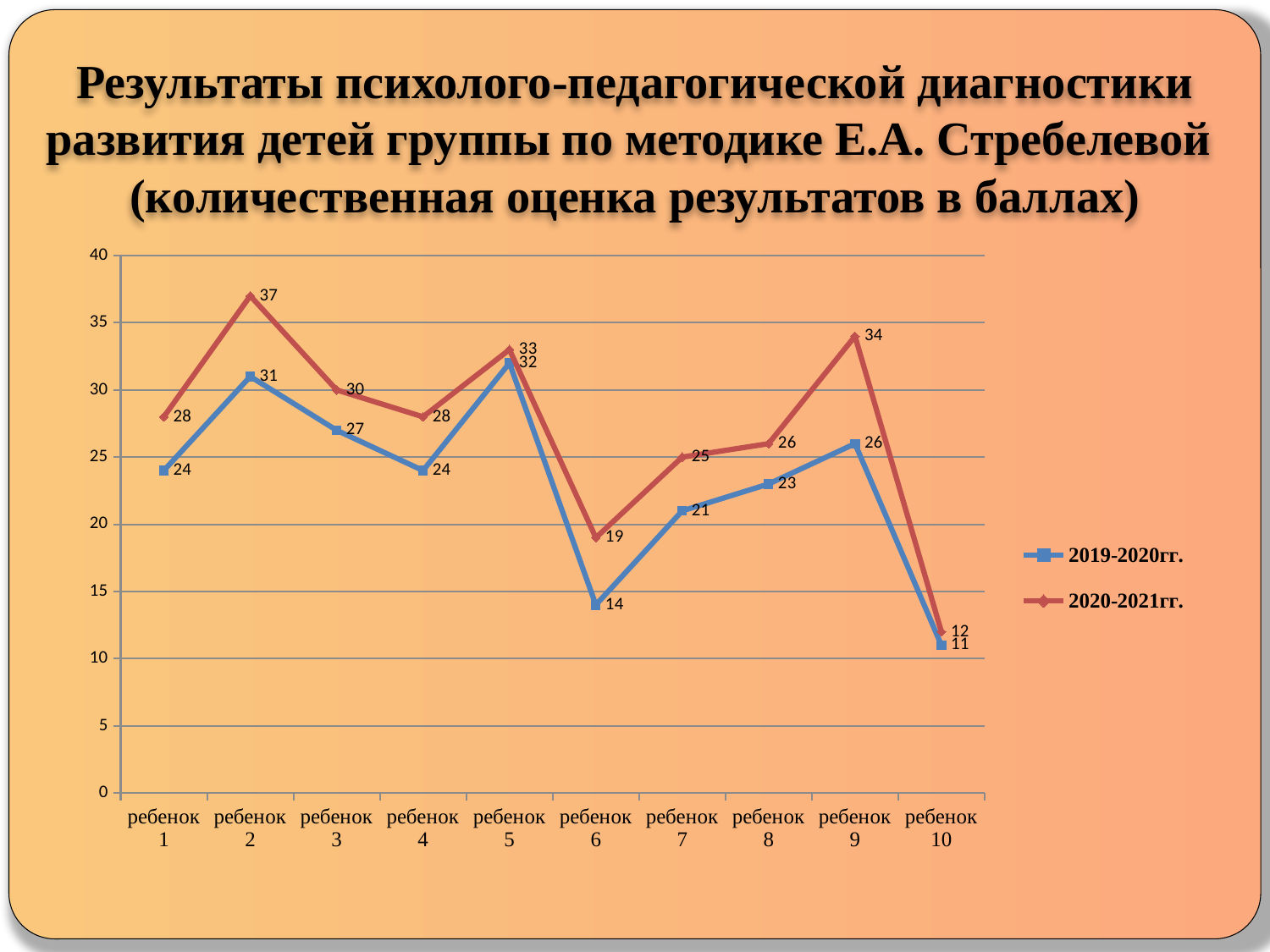
Which child has the lowest value in the 2019-2020гг. series? ребенок 10 How many series does the legend list? 2 Which is larger for ребенок 6: the 2019-2020гг. value or the 2020-2021гг. value? 2020-2021гг. What is the difference between the 2020-2021гг. values for ребенок 2 and ребенок 10? 25 What is the value for ребенок 9 in the 2020-2021гг. series? 34 What kind of chart is shown on the slide? line chart How many children (categories) are plotted along the x axis? 10 Is the 2019-2020гг. value for ребенок 2 greater or less than 30? greater Which child has the highest value in the 2020-2021гг. series? ребенок 2 What is the difference between the 2020-2021гг. and 2019-2020гг. values for ребенок 9? 8 What is the value for ребенок 5 in the 2019-2020гг. series? 32 Which series is drawn in red? 2020-2021гг.